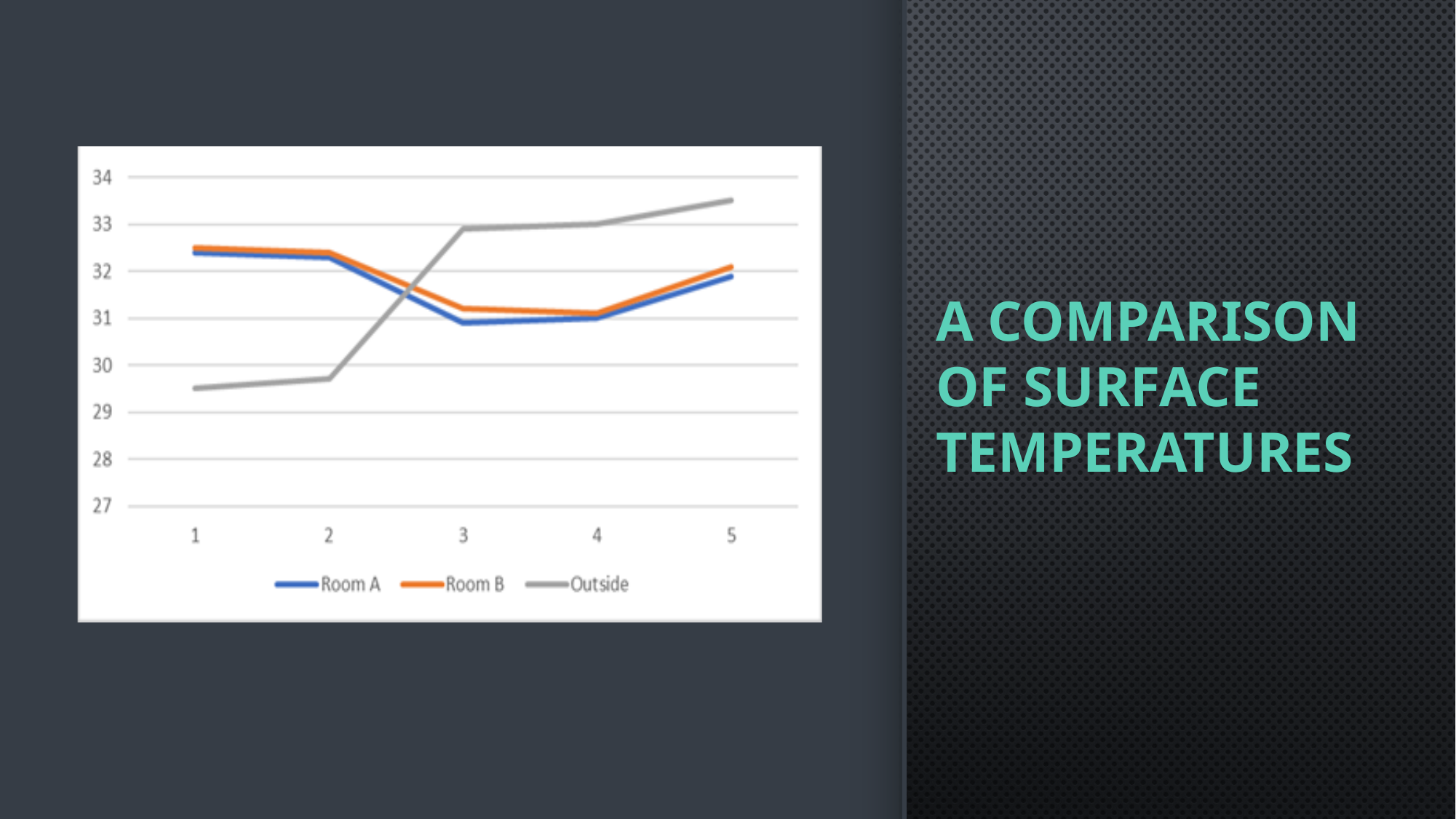
At point 1, which is larger: Room A or Outside? Room A Which series has the highest value at point 5? Outside How many series does the legend list? 3 Which series has the lowest value at point 1? Outside Does the Outside series rise or fall from point 1 to point 5? rise What are the three entries in the chart's legend? Room A, Room B, Outside Is the value for Room B at point 3 greater or less than 32? less How many points are plotted along the x axis for each series? 5 At point 4, which is larger: Outside or Room B? Outside What kind of chart is shown on the slide? line chart Is the value for Outside at point 1 greater or less than 30? less Is the value for Outside at point 5 greater or less than 33? greater